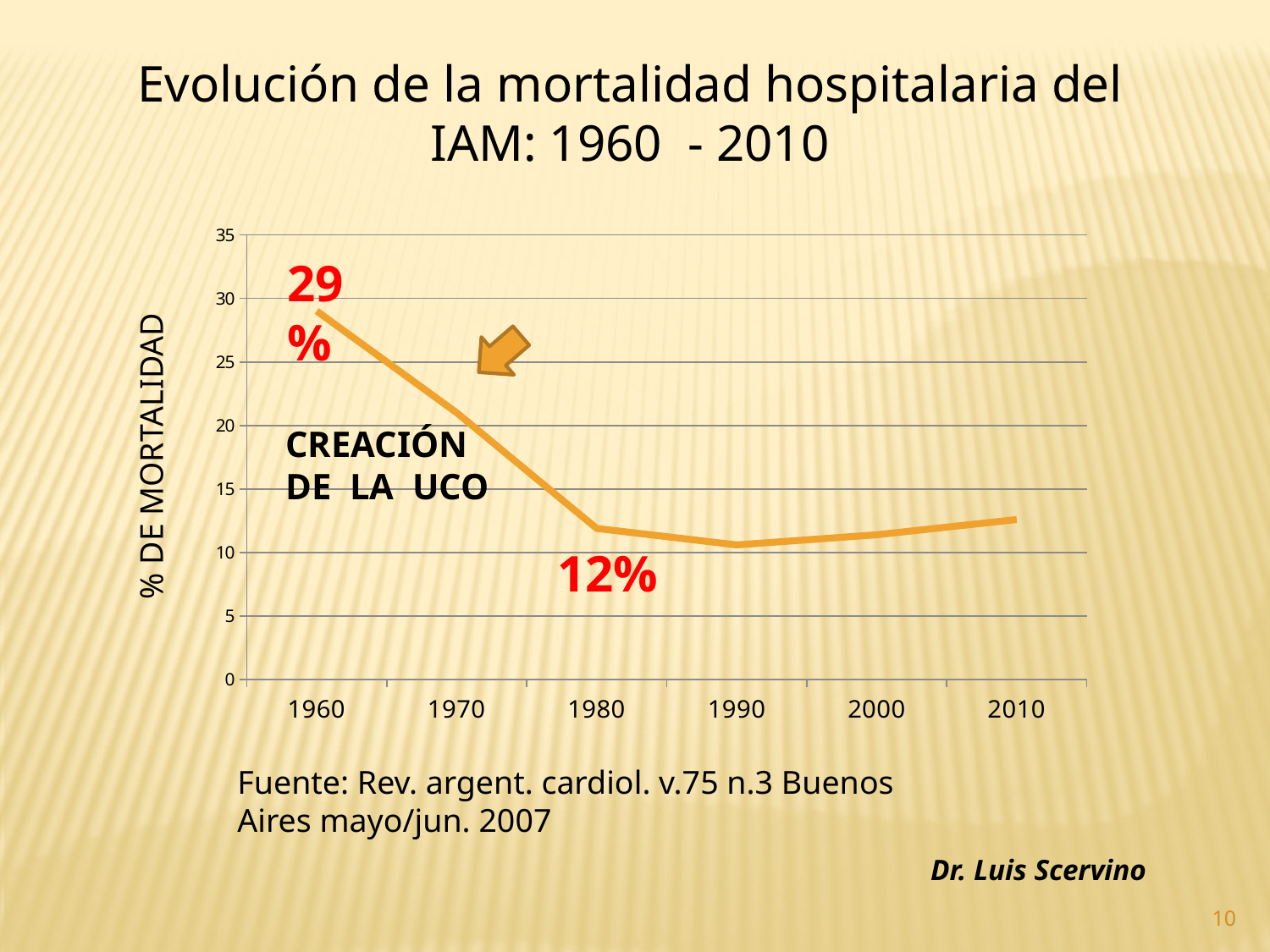
Which year has the highest mortality value on the chart? 1960 How many years are plotted on the x axis of the chart? 6 What is the hospital mortality value shown for 1980? 12% Which year has the lowest mortality value on the chart? 1990 What is the label on the vertical axis of the chart? % DE MORTALIDAD What kind of chart is shown on the slide? Line chart Does the mortality value rise or fall between 1960 and 1980? Fall What is the hospital mortality value shown for 1960? 29% Is the value for 1970 greater or less than 25? less Which year has the larger mortality value, 1960 or 1980? 1960 Is the value for 2010 greater or less than 15? less By how many percentage points did the labelled mortality fall from 1960 to 1980? 17